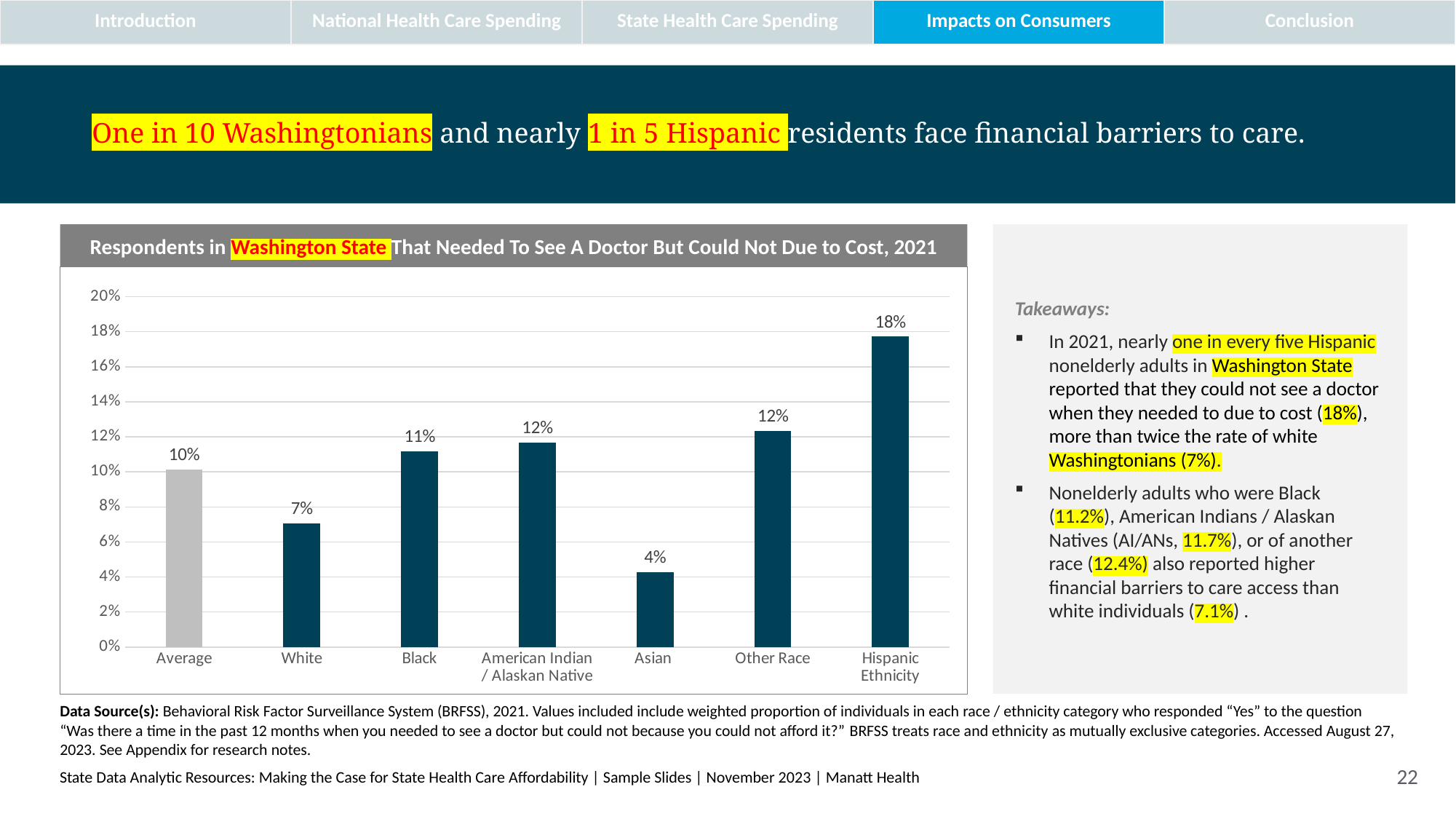
Which category has the highest value in the chart? Hispanic Ethnicity What is the title of the chart? Respondents in Washington State That Needed To See A Doctor But Could Not Due to Cost, 2021 Which is larger, the value for Black respondents or the value for Asian respondents? Black Is the value for Other Race greater or less than 10%? greater How many categories are shown on the x axis of the chart? 7 What value is shown for Asian respondents in the chart? 4% Which category has the lowest value in the chart? Asian What value is shown for White respondents in the chart? 7% What kind of chart is shown on the slide? Bar chart What is the difference between the Hispanic Ethnicity value and the White value, using the printed labels? 11% What value is shown for the Average bar in the chart? 10% What value is shown for Hispanic Ethnicity in the chart? 18%